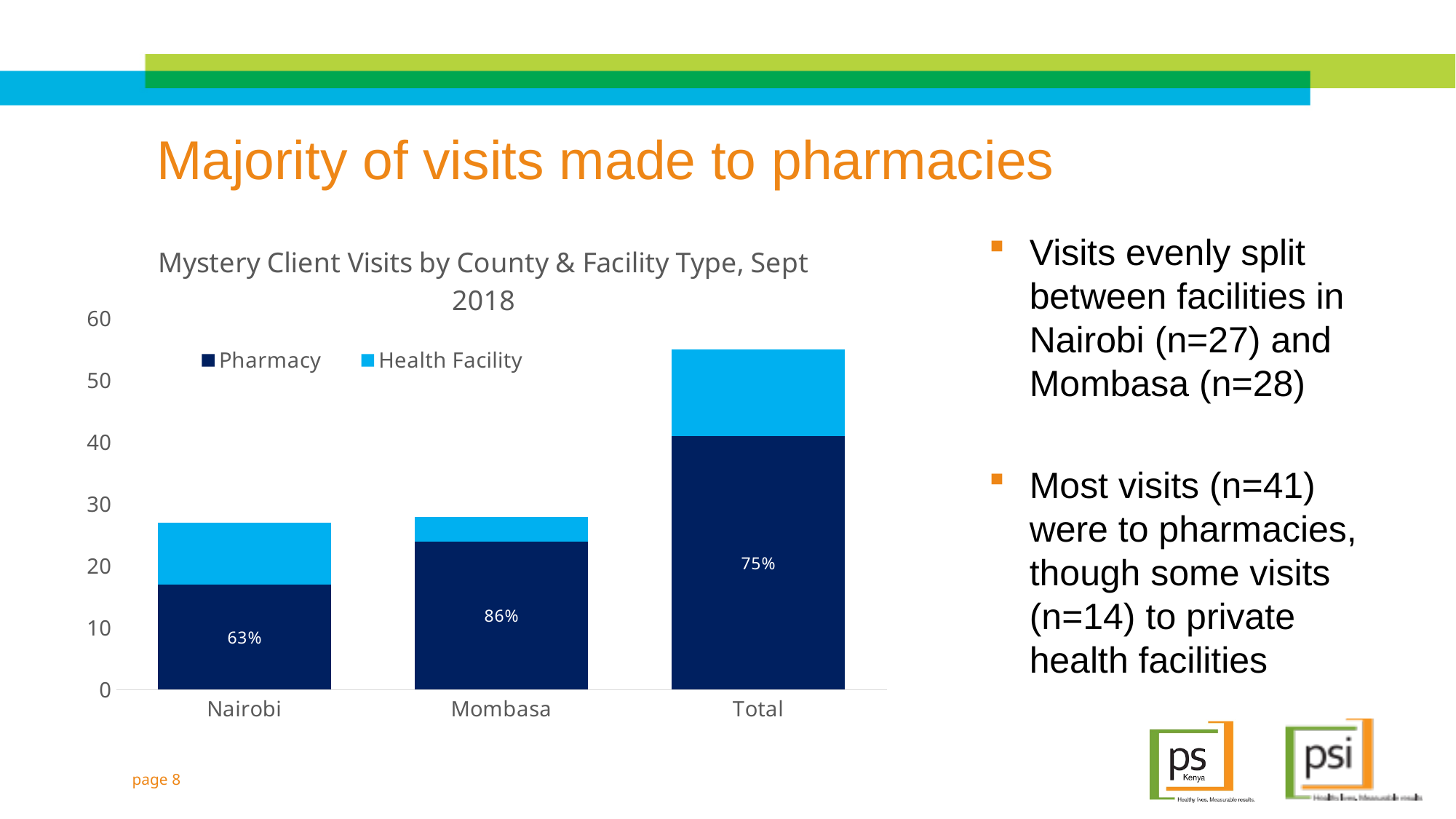
How many categories are shown on the x axis? 3 What is the title of the chart? Mystery Client Visits by County & Facility Type, Sept 2018 What kind of chart is shown on the slide? Stacked bar chart Is the Pharmacy segment for Nairobi greater or less than 20? less How many series does the legend list? 2 Is the total height of the Nairobi bar greater or less than 30? less What percentage label is shown on the Pharmacy segment for Total? 75% Which category has the tallest stacked bar? Total Is the total height of the Total bar greater or less than 50? greater What percentage label is shown on the Pharmacy segment for Mombasa? 86% What percentage label is shown on the Pharmacy segment for Nairobi? 63% Is the stacked bar for Total taller than the stacked bar for Nairobi? Yes